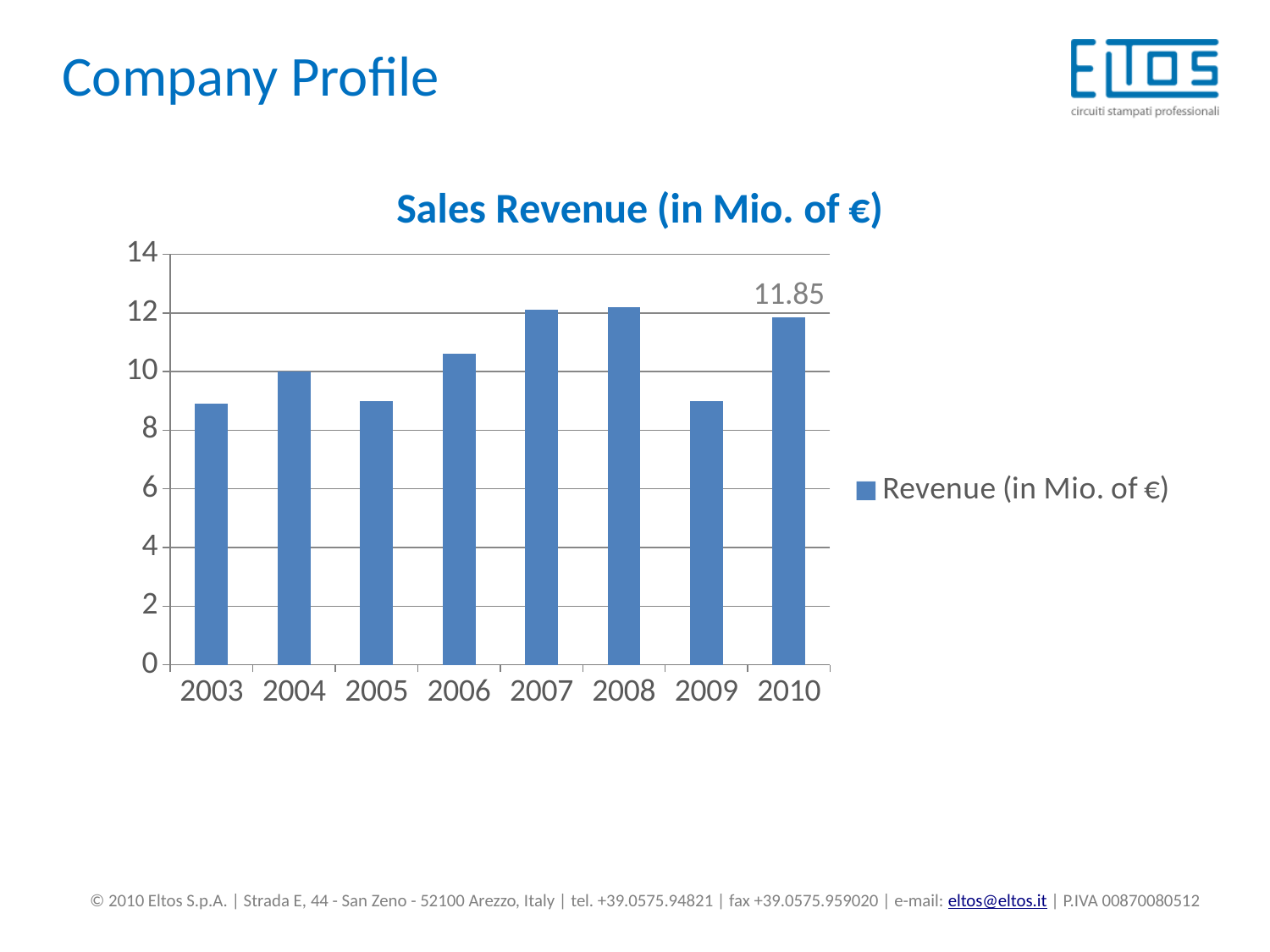
Is the value for 2009 greater or less than 10? less Which year has the larger value, 2010 or 2009? 2010 Which year has the larger value, 2007 or 2006? 2007 How many years are shown on the x axis of the chart? 8 Do the values rise or fall from 2005 to 2008? rise What is the legend entry shown for the series? Revenue (in Mio. of €) What type of chart is shown on the slide? bar chart What is the title of the chart? Sales Revenue (in Mio. of €) Is the value for 2003 greater or less than 10? less What is the value for 2010 in the Sales Revenue chart? 11.85 Is the value for 2006 greater or less than 10? greater How many series does the legend list? 1